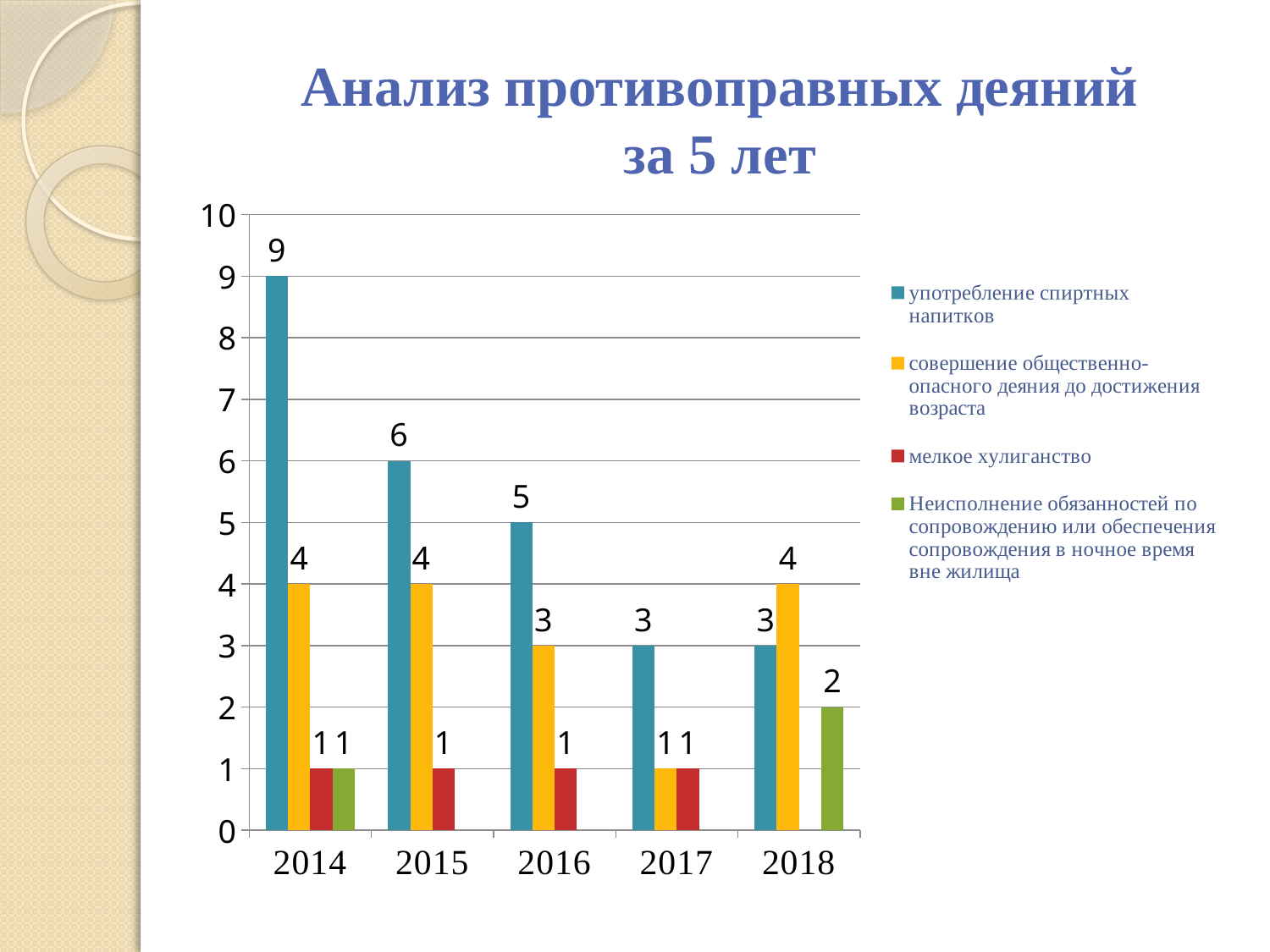
What is the value for 'совершение общественно-опасного деяния до достижения возраста' in 2016? 3 What is the difference between the 'употребление спиртных напитков' values for 2014 and 2015? 3 What is the value for 'употребление спиртных напитков' in 2014? 9 How many years are shown on the x axis? 5 Does the value for 'употребление спиртных напитков' rise or fall from 2014 to 2017? fall In which year is the value for 'совершение общественно-опасного деяния до достижения возраста' lowest? 2017 What is the value for 'Неисполнение обязанностей по сопровождению или обеспечения сопровождения в ночное время вне жилища' in 2018? 2 In 2018, which is larger: 'употребление спиртных напитков' or 'совершение общественно-опасного деяния до достижения возраста'? совершение общественно-опасного деяния до достижения возраста What type of chart is shown on the slide? bar chart What is the title of the chart on the slide? Анализ противоправных деяний за 5 лет How many series does the legend list? 4 In which year is the value for 'употребление спиртных напитков' highest? 2014